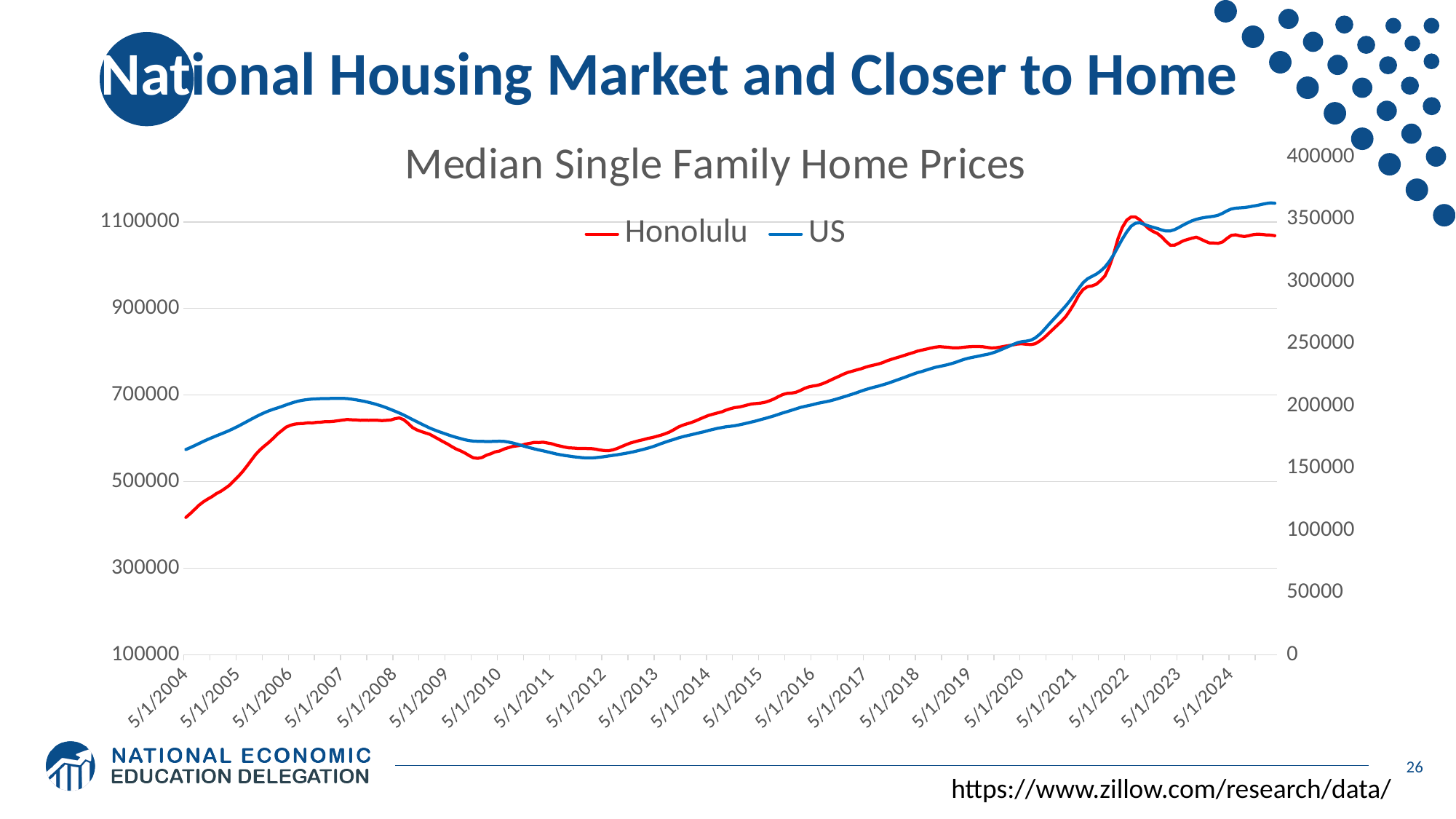
Is the Honolulu value at 5/1/2010 greater or less than 500000 on the left axis? greater Does the Honolulu line rise or fall between 5/1/2012 and 5/1/2022? Rise What is the title of the chart? Median Single Family Home Prices Which series is drawn in red? Honolulu How many series does the legend list? 2 Is the Honolulu value at 5/1/2007 greater or less than 700000 on the left axis? less How many dated labels are shown along the x axis? 21 What kind of chart is shown on the slide? Line chart Is the US value at the end of the series (after 5/1/2024) greater or less than 350000 on the right axis? greater Does the Honolulu line rise or fall between 5/1/2008 and 5/1/2010? Fall